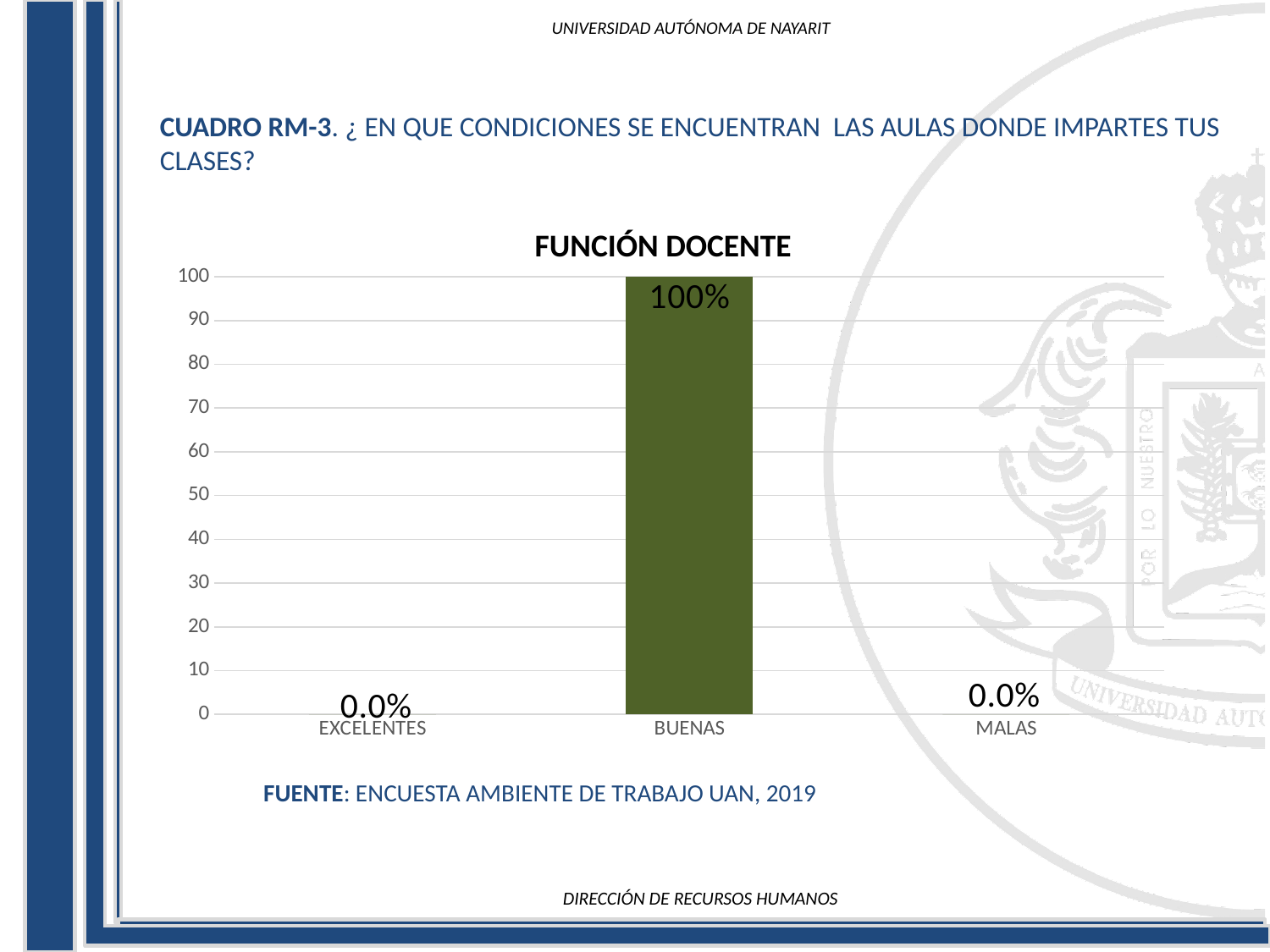
What is the value for MALAS? 0.0% What is the title of the chart? FUNCIÓN DOCENTE What is the value for BUENAS? 100% What is the difference between the values for BUENAS and MALAS? 100% What is the highest value shown on the y axis? 100 How many categories are shown on the x axis? 3 Is the value for BUENAS greater or less than 50? greater Which is larger, the value for BUENAS or the value for EXCELENTES? BUENAS Which category has the highest value? BUENAS What kind of chart is shown? bar chart What is the value for EXCELENTES? 0.0%